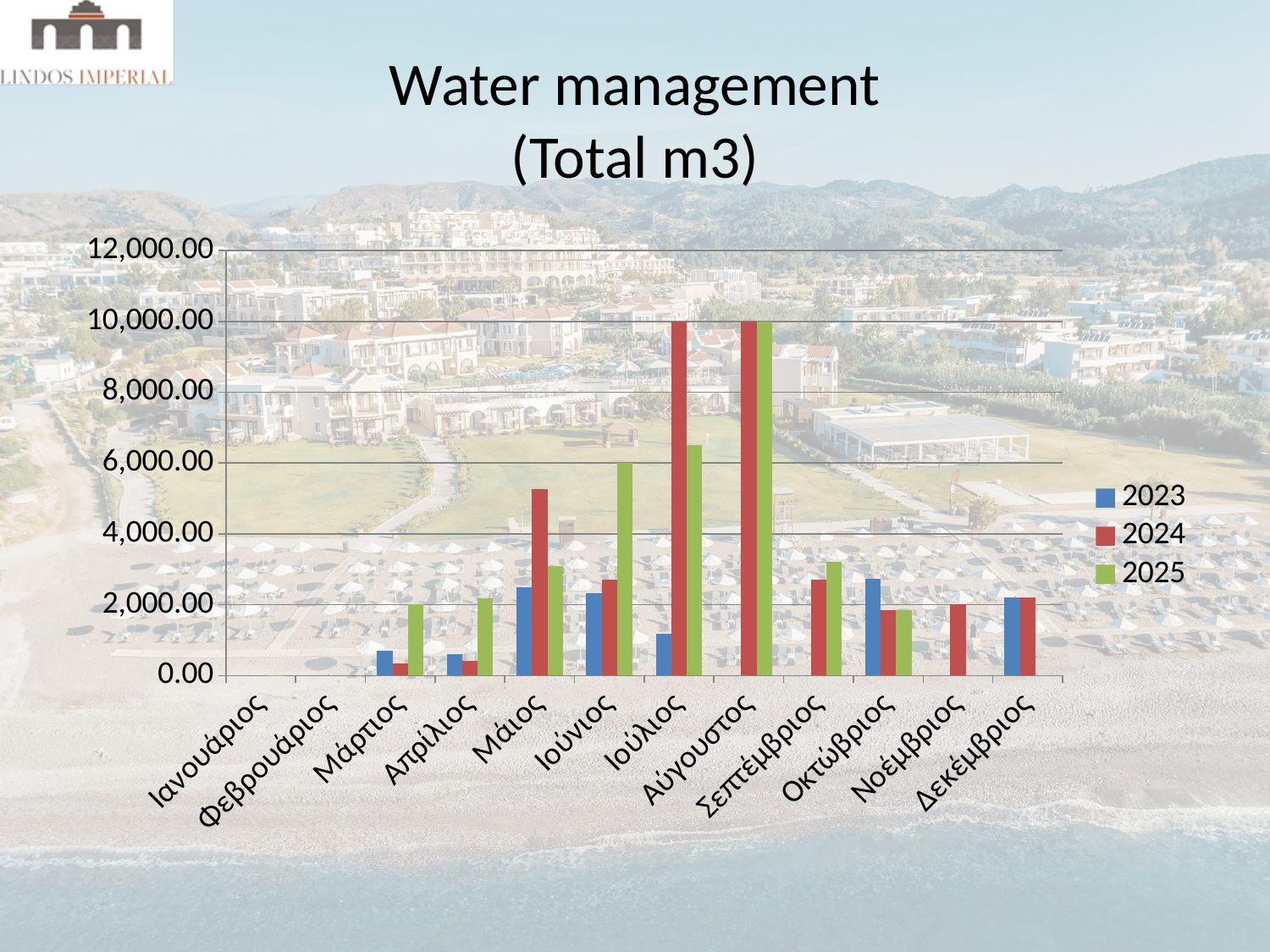
Is the 2025 value for Σεπτέμβριος greater or less than 4,000.00? less Which is larger for Μάιος, the 2023 value or the 2024 value? 2024 Is the 2024 value for Μάιος greater or less than 4,000.00? greater What is the title of the chart? Water management (Total m3) How many series does the legend list? 3 Is the 2024 value for Ιούλιος greater or less than 8,000.00? greater How many categories (months) are shown on the x axis? 12 Which years are listed in the legend? 2023, 2024, 2025 Which is larger for Οκτώβριος, the 2023 value or the 2024 value? 2023 For the 2025 series, do the values rise or fall from Μάρτιος to Αύγουστος? rise What kind of chart is shown on the slide? bar chart